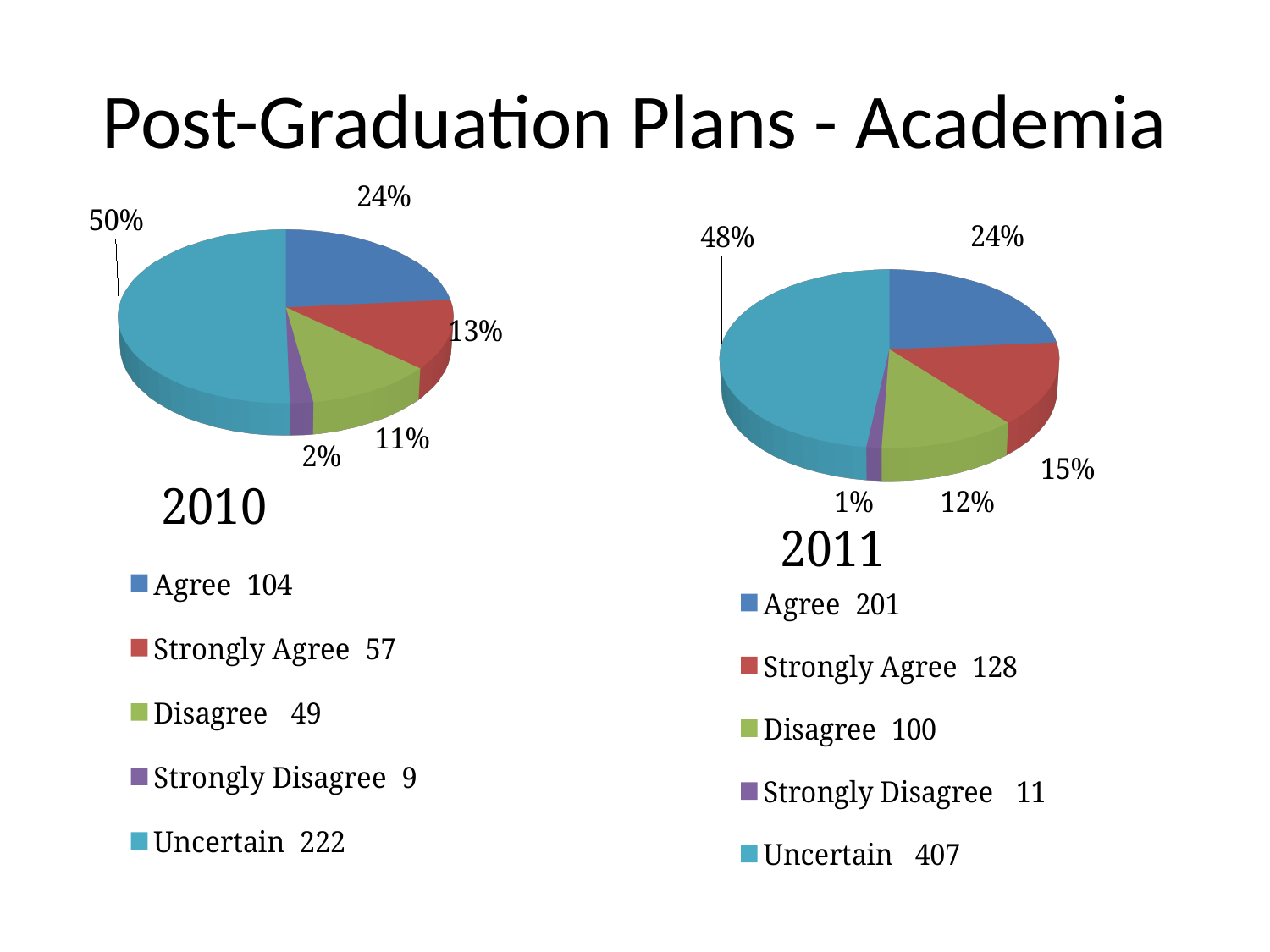
In the 2011 chart, what percentage of the pie is Strongly Agree? 15% In the 2010 chart, what percentage of the pie is Strongly Disagree? 2% In the 2010 chart, which is larger, the Disagree slice or the Strongly Agree slice? Strongly Agree In the 2011 chart, what count does the legend show for Uncertain? 407 In the 2010 chart, what count does the legend show for Agree? 104 In the 2010 chart, which category has the largest slice? Uncertain In the 2011 chart, what is the difference between the Agree count and the Strongly Agree count shown in the legend? 73 How many categories does the 2011 chart's legend list? 5 In the 2010 chart, what percentage of the pie is Uncertain? 50% In the 2011 chart, which category has the smallest slice? Strongly Disagree What is the title of the slide? Post-Graduation Plans - Academia What kind of chart is the 2010 chart? Pie chart